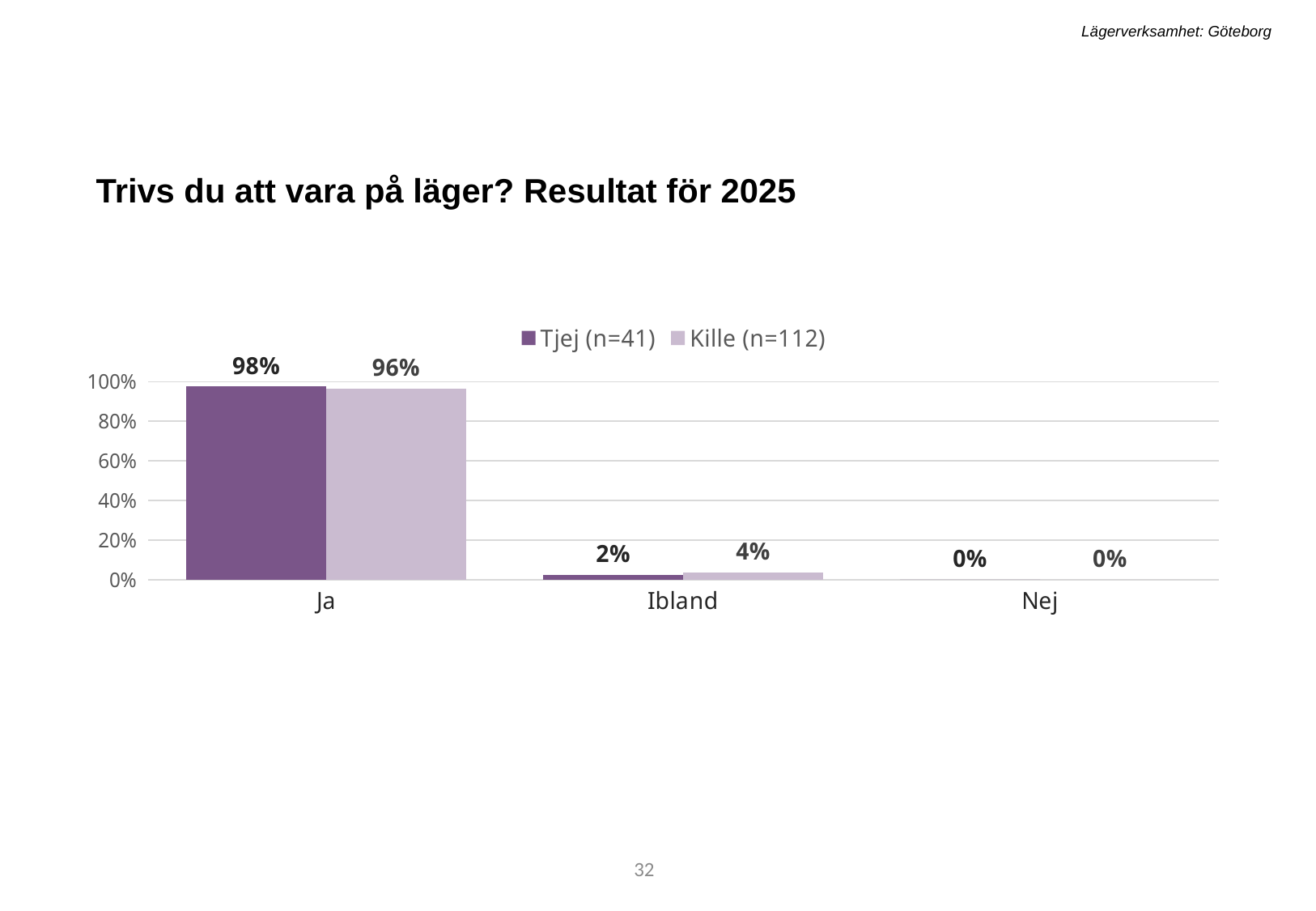
What is the value for Tjej (n=41) in the Ja category? 98% What is the value for Kille (n=112) in the Ja category? 96% How many series does the legend list? 2 Is the value for Kille (n=112) in the Ja category greater or less than 80%? greater What is the value for Kille (n=112) in the Ibland category? 4% What is the difference between the Tjej (n=41) and Kille (n=112) values in the Ja category? 2% How many categories are shown on the x axis? 3 Which category has the highest value for Tjej (n=41)? Ja What is the value for Tjej (n=41) in the Ibland category? 2% What kind of chart is shown on the slide? Bar chart What is the value for Kille (n=112) in the Nej category? 0% Which is larger in the Ibland category, Tjej (n=41) or Kille (n=112)? Kille (n=112)